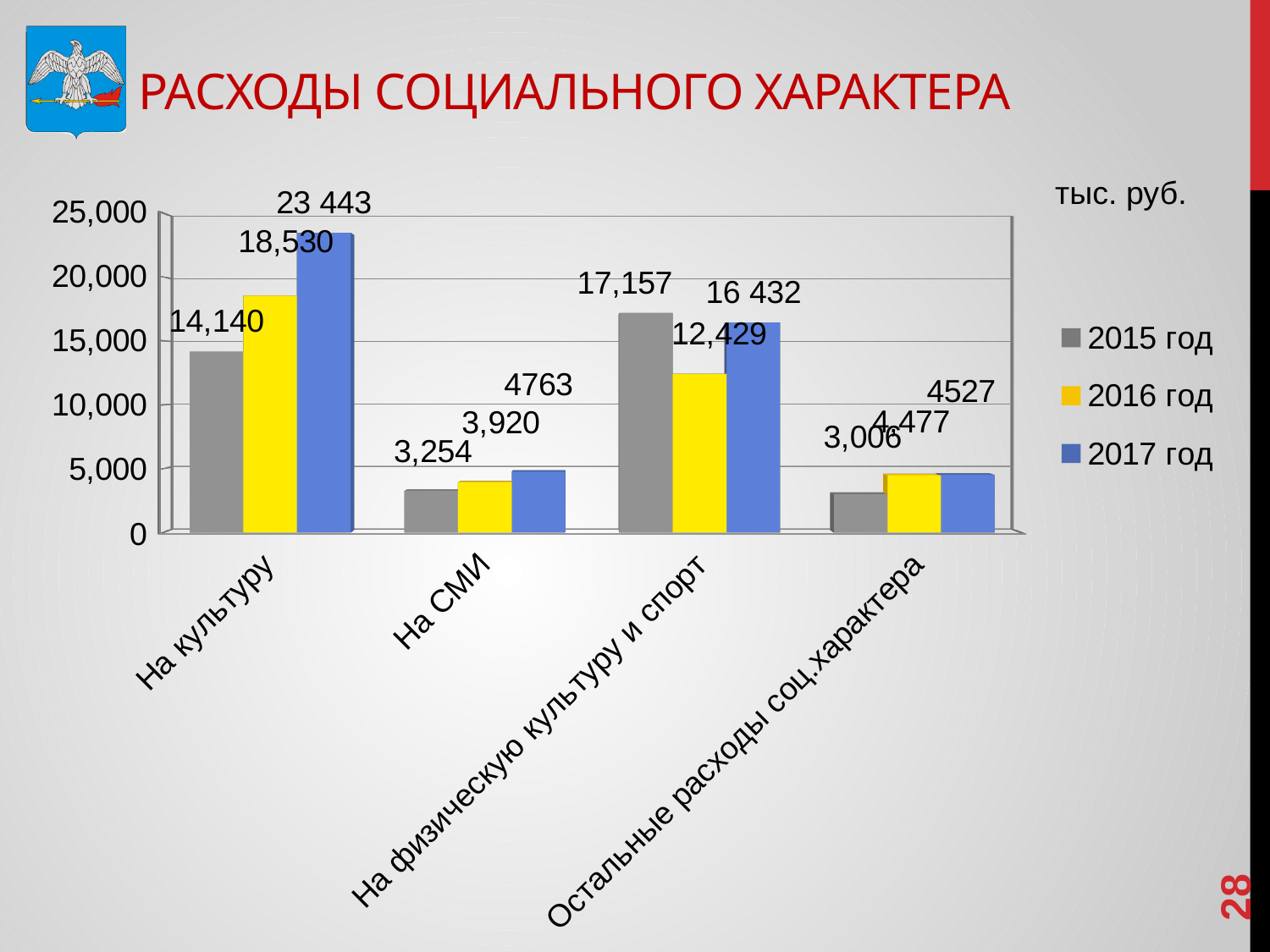
What is the value for "На культуру" in the 2017 год series? 23 443 How many series does the legend list? 3 What is the value for "На физическую культуру и спорт" in the 2016 год series? 12,429 How many categories are shown on the x axis? 4 What is the value for "Остальные расходы соц.характера" in the 2017 год series? 4527 Which category has the highest value in the 2017 год series? На культуру What is the difference between the 2017 год and 2015 год values for "На культуру"? 9,303 What is the value for "На СМИ" in the 2016 год series? 3,920 For "На физическую культуру и спорт", which is larger: the 2015 год value or the 2017 год value? 2015 год What is the value for "На культуру" in the 2015 год series? 14,140 What kind of chart is shown on the slide? Bar chart Which category has the lowest value in the 2015 год series? Остальные расходы соц.характера